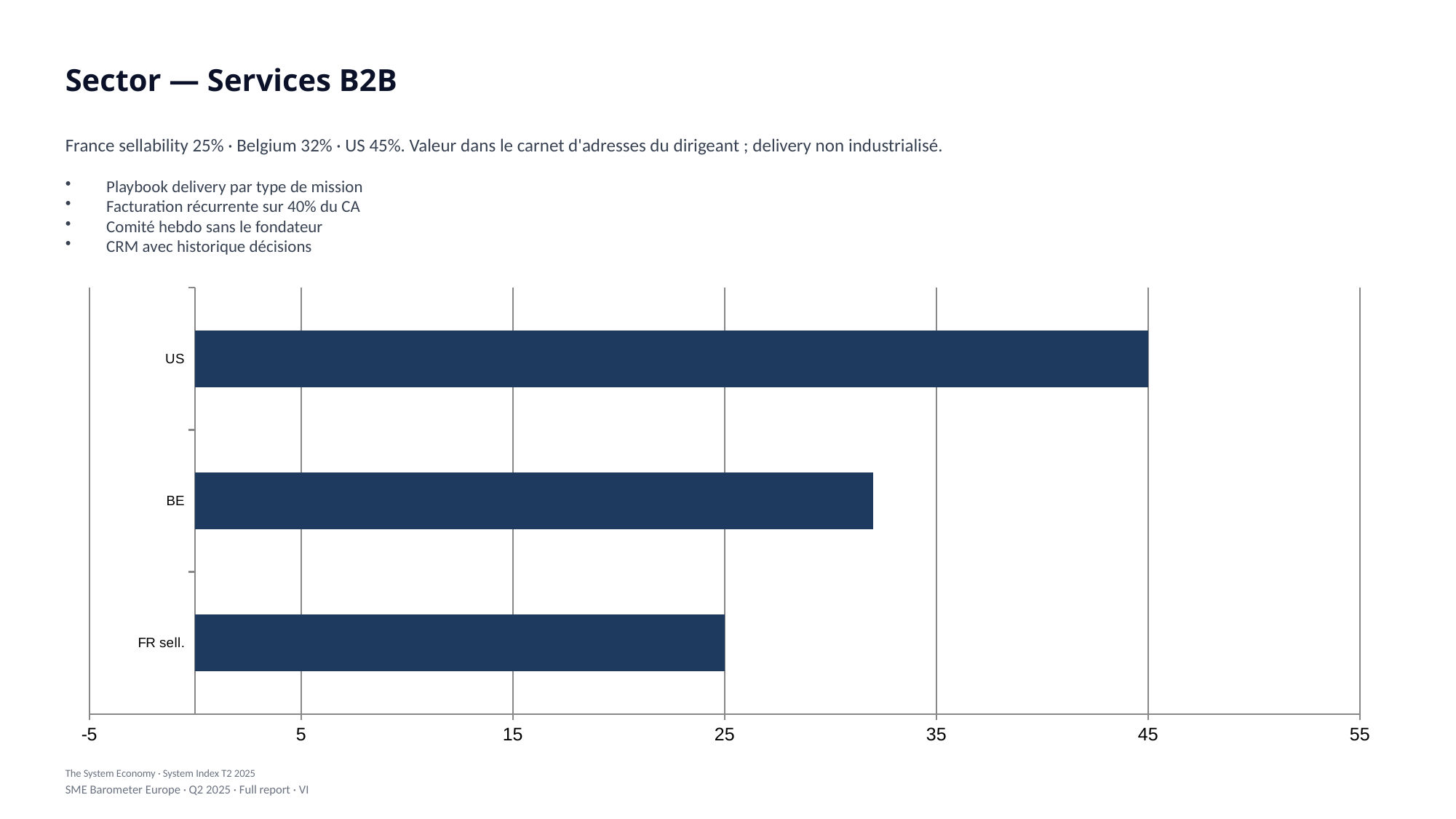
Which category has the highest value in the bar chart? US What is the difference between the US value and the FR sell. value? 20 What is the value of the US bar? 45 What kind of chart is shown on the slide? bar chart What is the title of the slide containing the bar chart? Sector — Services B2B Which category has the lowest value in the bar chart? FR sell. Is the value for BE greater or less than 25? greater Is the value for BE greater or less than 35? less Is the value for US greater or less than 35? greater How many categories does the bar chart show? 3 Which is larger, the value for BE or the value for FR sell.? BE What is the value of the FR sell. bar? 25